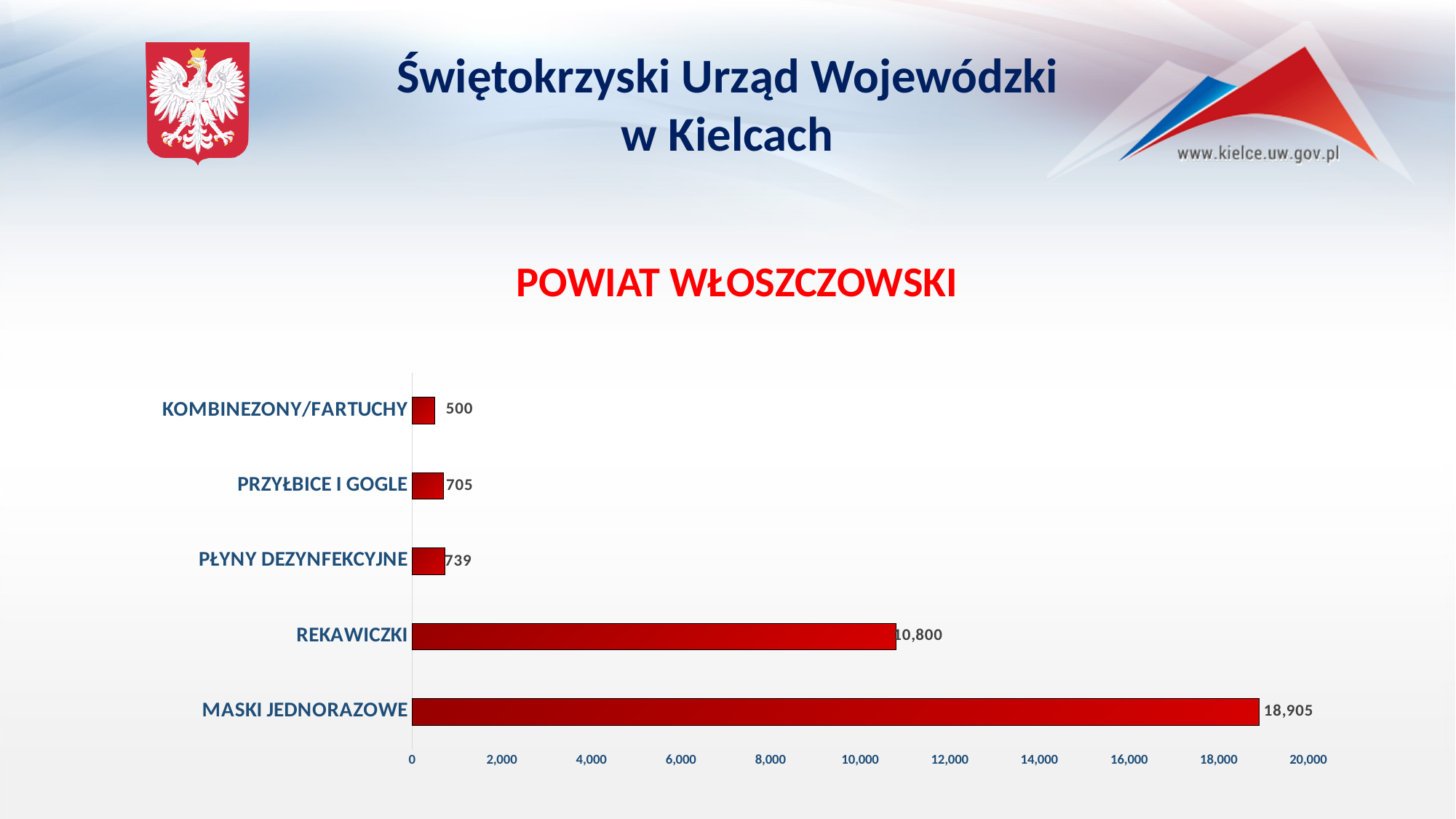
How many categories are shown in the chart? 5 Which category has the lowest value? KOMBINEZONY/FARTUCHY Which is larger, the value for PŁYNY DEZYNFEKCYJNE or the value for PRZYŁBICE I GOGLE? PŁYNY DEZYNFEKCYJNE What kind of chart is shown on the slide? bar chart What is the value for PŁYNY DEZYNFEKCYJNE? 739 What is the value for MASKI JEDNORAZOWE? 18,905 What is the value for KOMBINEZONY/FARTUCHY? 500 Is the value for REKAWICZKI greater or less than 10,000? greater Which category has the highest value? MASKI JEDNORAZOWE What is the value for PRZYŁBICE I GOGLE? 705 What is the difference between the values for MASKI JEDNORAZOWE and REKAWICZKI? 8,105 What is the value for REKAWICZKI? 10,800